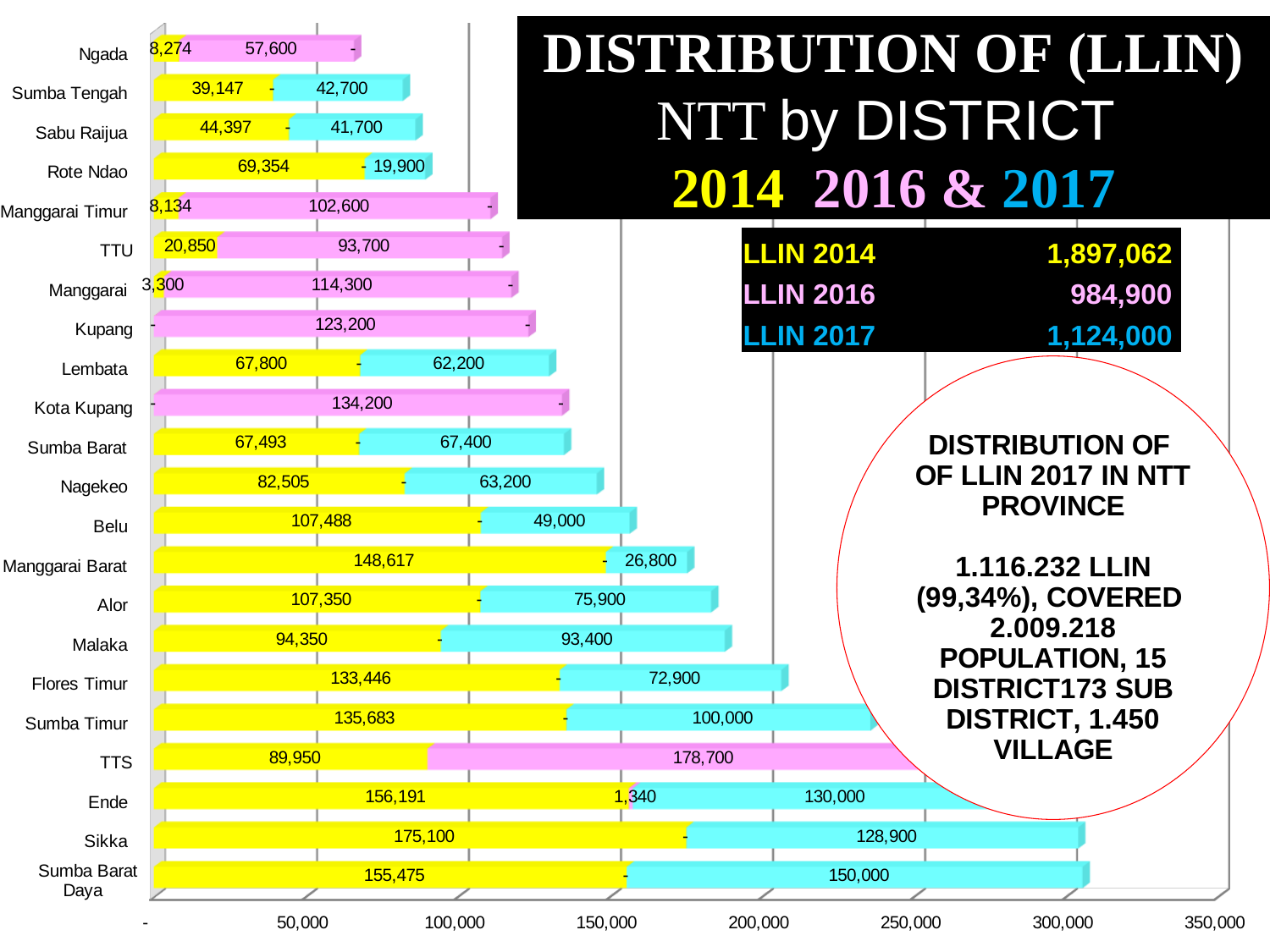
For Malaka, which is larger: the 2014 value or the 2017 value? 2014 What is the 2016 (pink) value for TTS? 178,700 Which district has the highest 2014 (yellow) value? Sikka What is the 2014 (yellow) value for Sikka? 175,100 What is the total of the stacked bar for Sikka? 304,000 Which district has the highest 2016 (pink) value? TTS What kind of chart is shown on the slide? bar chart How many districts are listed on the chart? 22 What is the difference between the 2014 and 2017 values for Alor? 31,450 What is the 2014 (yellow) value for Manggarai? 3,300 What is the 2017 (blue) value for Sumba Barat Daya? 150,000 What is the 2016 (pink) value for Kota Kupang? 134,200